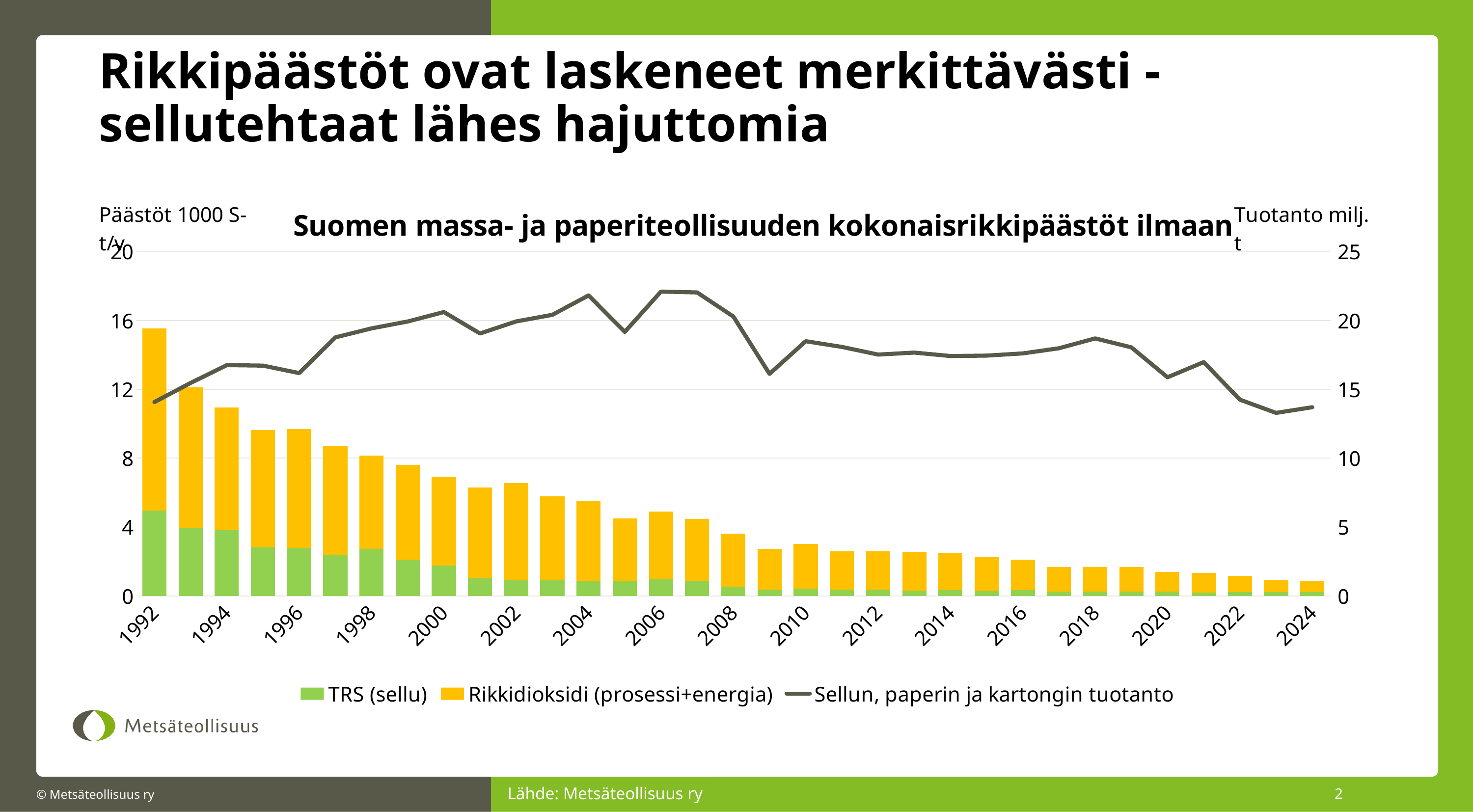
What is the title of the chart? Suomen massa- ja paperiteollisuuden kokonaisrikkipäästöt ilmaan What kind of chart is shown on the slide? A stacked bar chart combined with a line chart How many years (bars) are plotted on the x axis from 1992 to 2024? 33 Is the production line value for 2006 greater or less than 20 on the right axis? greater Is the total emissions bar for 1992 greater or less than 12 on the left axis? greater Which is larger, the total emissions bar for 1992 or for 2000? 1992 Is the production line value for 2024 greater or less than 15 on the right axis? less Which year has the highest total sulphur emissions bar? 1992 What are the three series named in the legend? TRS (sellu); Rikkidioksidi (prosessi+energia); Sellun, paperin ja kartongin tuotanto Do the total emission bars rise or fall from 1992 to 2024? Fall How many series does the legend list? 3